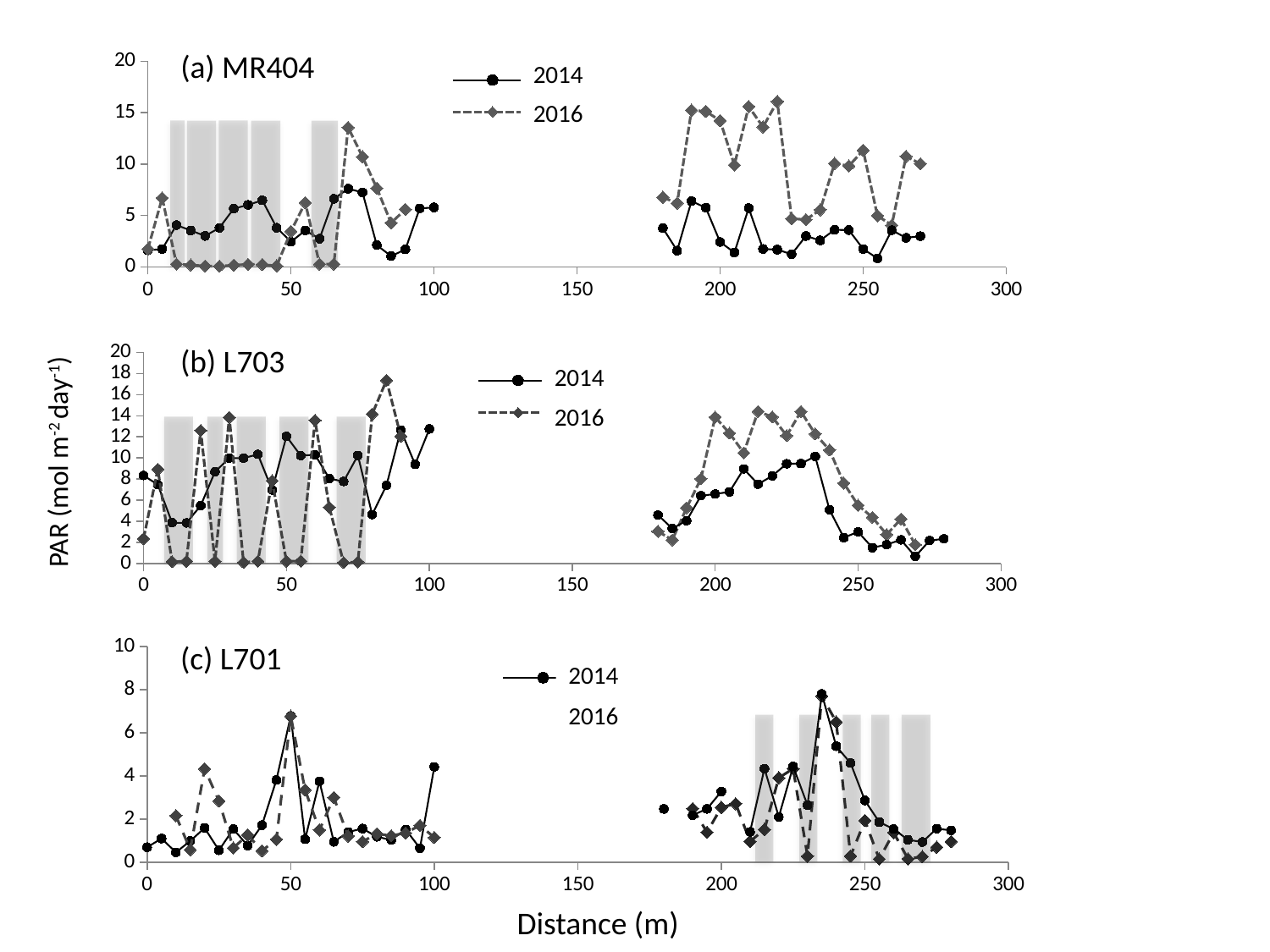
In chart (b) L703, is the 2016 value at 85 m greater or less than 16? greater In chart (b) L703, is the 2014 value at 270 m greater or less than 2? less In chart (a) MR404, is the 2016 value at 190 m greater or less than 10? greater How many charts are shown on the slide? 3 What is the title of the bottom chart? (c) L701 What is the x-axis label shared by the charts? Distance (m) In chart (a) MR404, at 220 m, which series has the larger value, 2014 or 2016? 2016 How many series does the legend of chart (b) L703 list? 2 What kind of chart is the top chart, (a) MR404? line chart In chart (b) L703, which series reaches the highest value on the chart? 2016